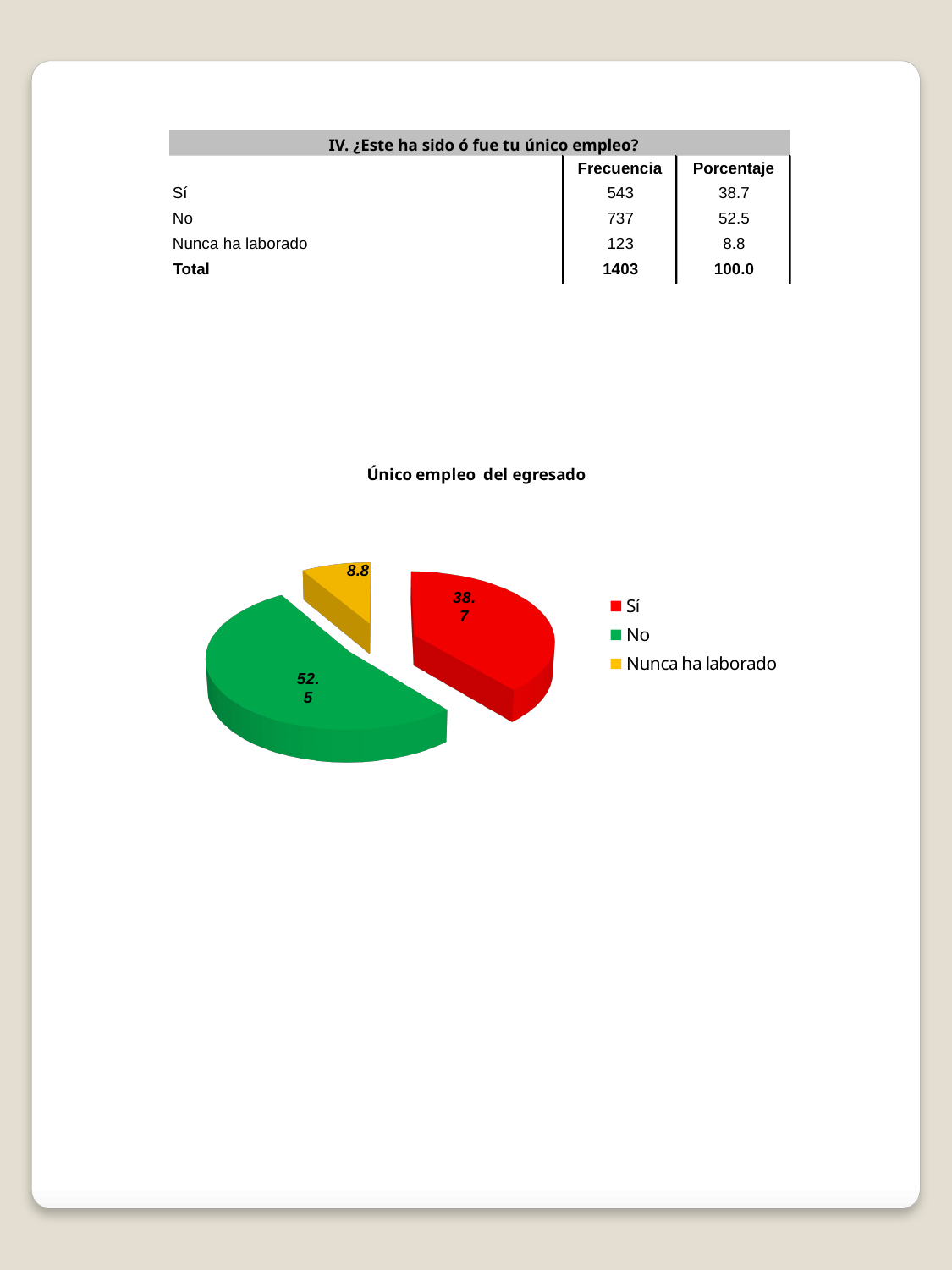
Which is larger in the pie chart, the value for "Sí" or the value for "Nunca ha laborado"? Sí How many entries does the legend of the pie chart list? 3 What is the value shown for the "No" slice in the pie chart? 52.5 What colour is the "No" slice in the pie chart? green Which category has the largest slice in the pie chart? No What is the value shown for the "Sí" slice in the pie chart? 38.7 What is the difference between the values for "No" and "Sí" in the pie chart? 13.8 Which category has the smallest slice in the pie chart? Nunca ha laborado What kind of chart is shown under the title "Único empleo del egresado"? pie chart How many slices does the pie chart have? 3 What is the title of the pie chart? Único empleo del egresado What is the value shown for the "Nunca ha laborado" slice in the pie chart? 8.8